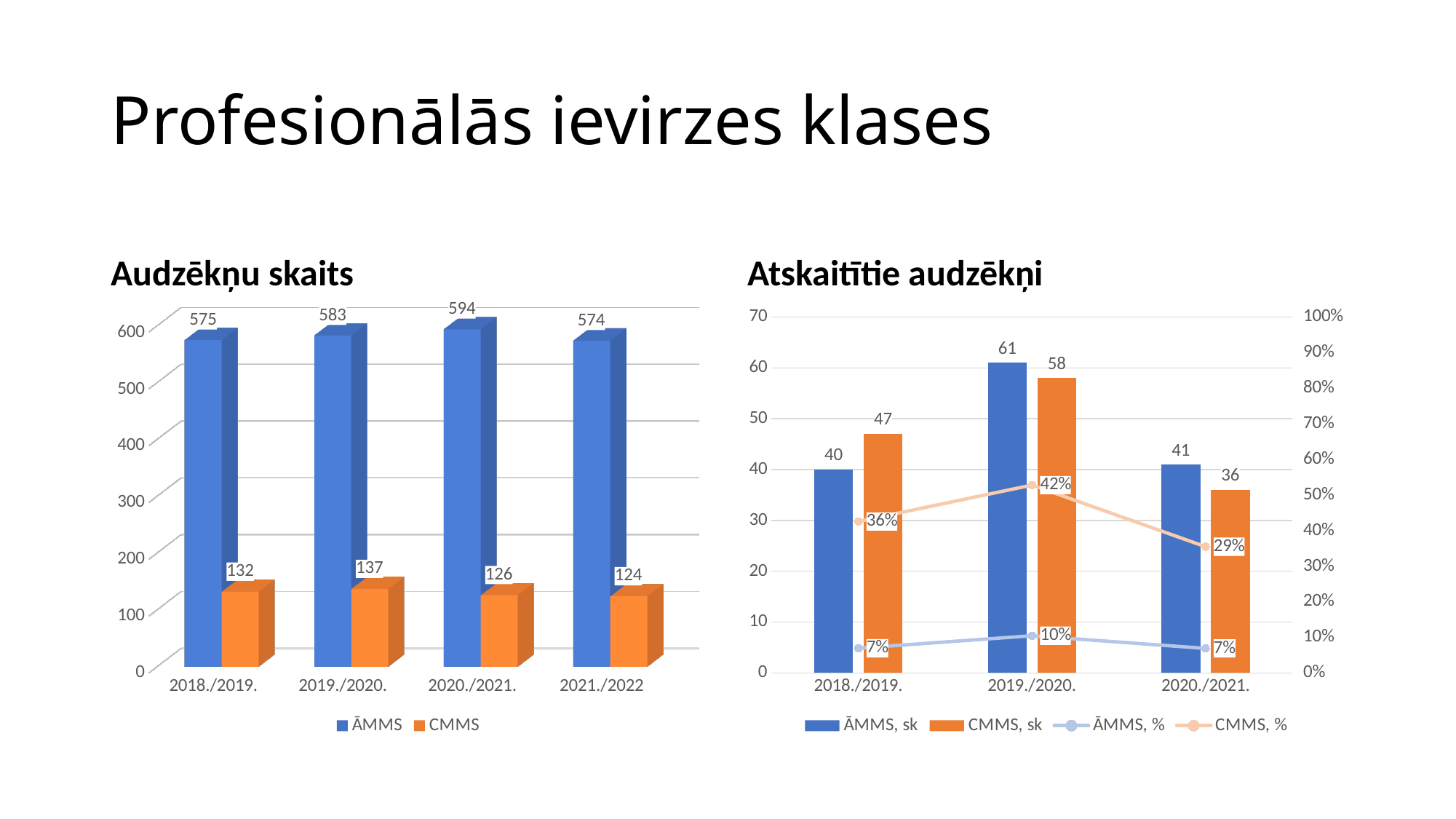
In the 'Audzēkņu skaits' chart, what is the CMMS value for 2019./2020.? 137 What kind of chart is the 'Audzēkņu skaits' chart? Bar chart In the 'Audzēkņu skaits' chart, what is the ĀMMS value for 2020./2021.? 594 In the 'Audzēkņu skaits' chart, what is the difference between the ĀMMS and CMMS values for 2018./2019.? 443 In the 'Audzēkņu skaits' chart, which year has the lowest CMMS value? 2021./2022 In the 'Atskaitītie audzēkņi' chart, what is the CMMS, % value for 2020./2021.? 29% In the 'Atskaitītie audzēkņi' chart, which year has the highest ĀMMS, sk value? 2019./2020. In the 'Atskaitītie audzēkņi' chart, what is the CMMS, sk value for 2019./2020.? 58 In the 'Audzēkņu skaits' chart, which year has the highest ĀMMS value? 2020./2021. In the 'Atskaitītie audzēkņi' chart, is the ĀMMS, sk value or the CMMS, sk value larger for 2020./2021.? ĀMMS, sk In the 'Audzēkņu skaits' chart, how many year categories are shown on the x axis? 4 In the 'Atskaitītie audzēkņi' chart, how many series does the legend list? 4